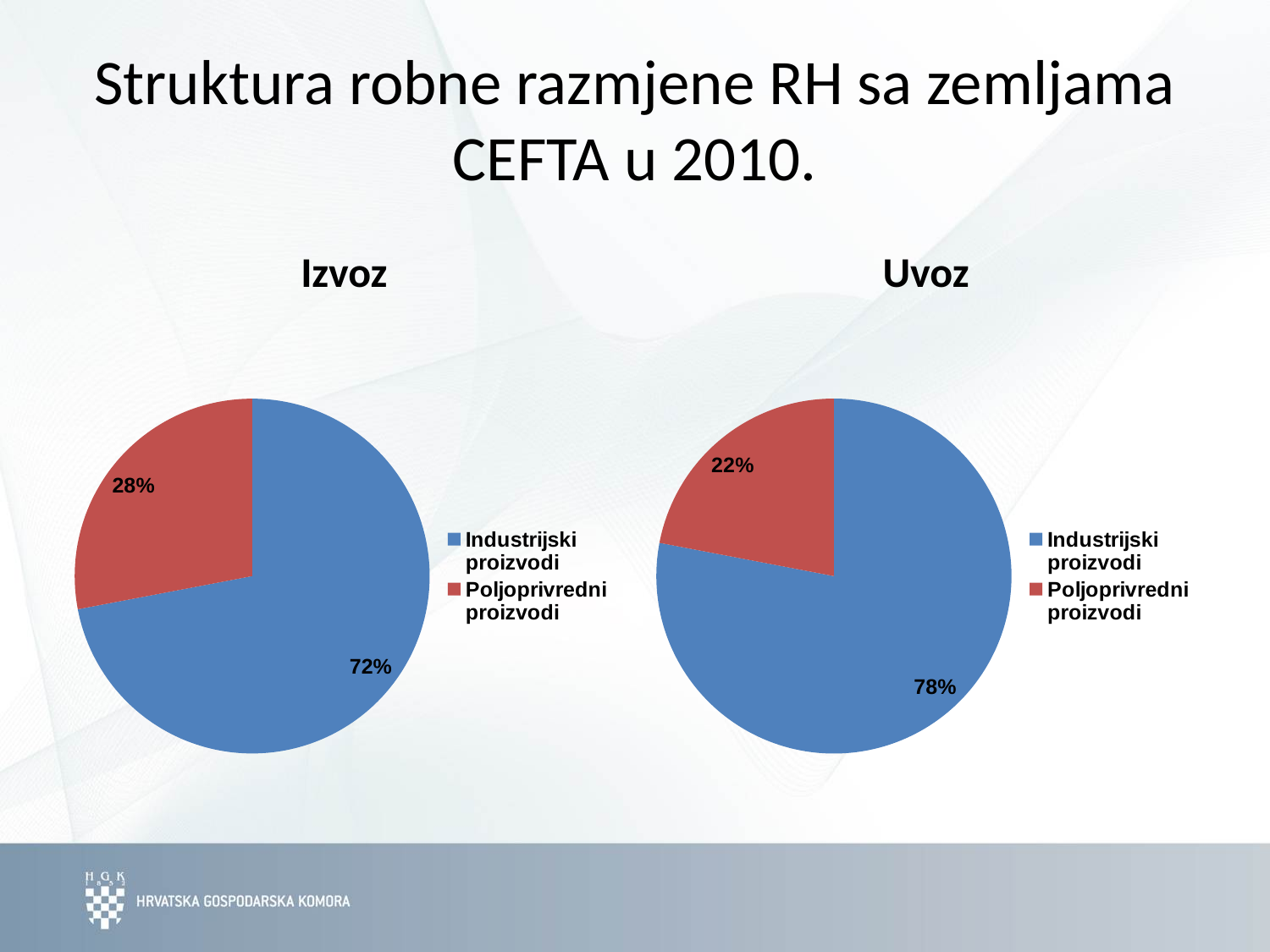
What type of chart is the Izvoz chart? Pie chart In the Uvoz chart, what colour is the slice for Poljoprivredni proizvodi? Red In the Uvoz chart, what share do Industrijski proizvodi have? 78% How many entries does the legend of the Izvoz chart list? 2 In the Uvoz chart, what is the difference in percentage points between Industrijski proizvodi and Poljoprivredni proizvodi? 56 percentage points In the Uvoz chart, what share do Poljoprivredni proizvodi have? 22% Is the share of Poljoprivredni proizvodi larger in the Izvoz chart or the Uvoz chart? Izvoz In the Izvoz chart, what share do Poljoprivredni proizvodi have? 28% How many slices does the Uvoz pie chart have? 2 In the Izvoz chart, what share do Industrijski proizvodi have? 72% In the Uvoz chart, which category has the smallest slice? Poljoprivredni proizvodi In the Izvoz chart, which category has the largest slice? Industrijski proizvodi